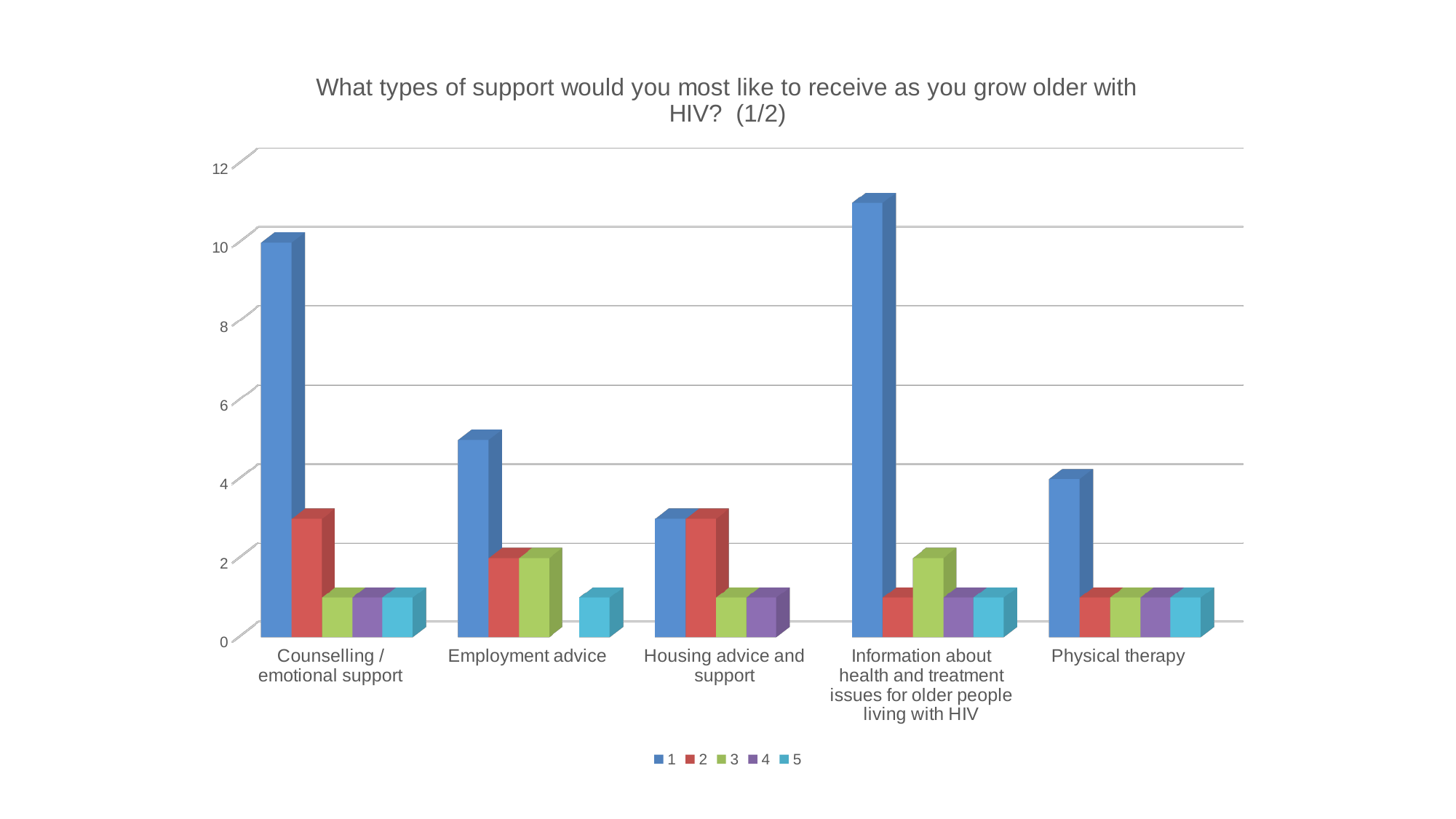
What is the title of the chart? What types of support would you most like to receive as you grow older with HIV? (1/2) Which category has the highest value for series 1? Information about health and treatment issues for older people living with HIV Is the value for series 1 in Housing advice and support greater or less than 4? less Is the value for series 1 in Counselling / emotional support greater or less than 8? greater Is the value for series 1 in Employment advice greater or less than 6? less Which category has the lowest value for series 1? Housing advice and support How many series does the legend list? 5 Which is larger for series 1: Counselling / emotional support or Employment advice? Counselling / emotional support How many categories are shown on the x axis? 5 Which is larger for series 2: Counselling / emotional support or Physical therapy? Counselling / emotional support What kind of chart is shown on the slide? bar chart